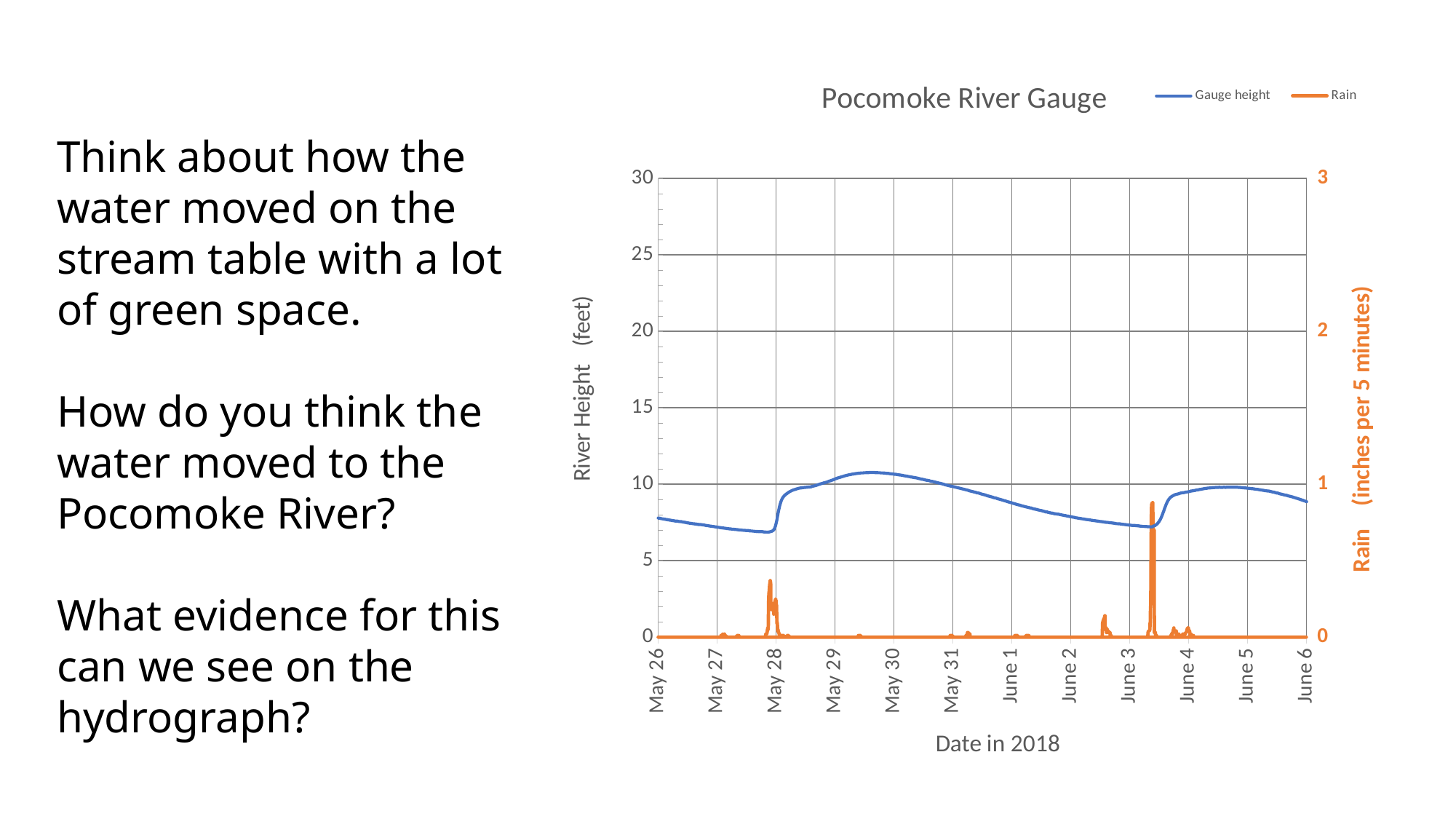
What is the title of the chart? Pocomoke River Gauge Which date has the larger rain spike, May 28 or June 3? June 3 What is the label of the right-hand vertical axis? Rain (inches per 5 minutes) Is the gauge height on May 30 greater or less than 10 feet? greater What kind of chart is shown on the slide? line chart Is the gauge height on May 26 greater or less than 10 feet? less Is the largest rain spike on May 28 greater or less than 1 inch per 5 minutes? less Is the gauge height higher on May 30 or on June 1? May 30 How many series does the legend list? 2 How many dates are labelled on the x axis? 12 Does the gauge height rise or fall between May 30 and June 3? fall